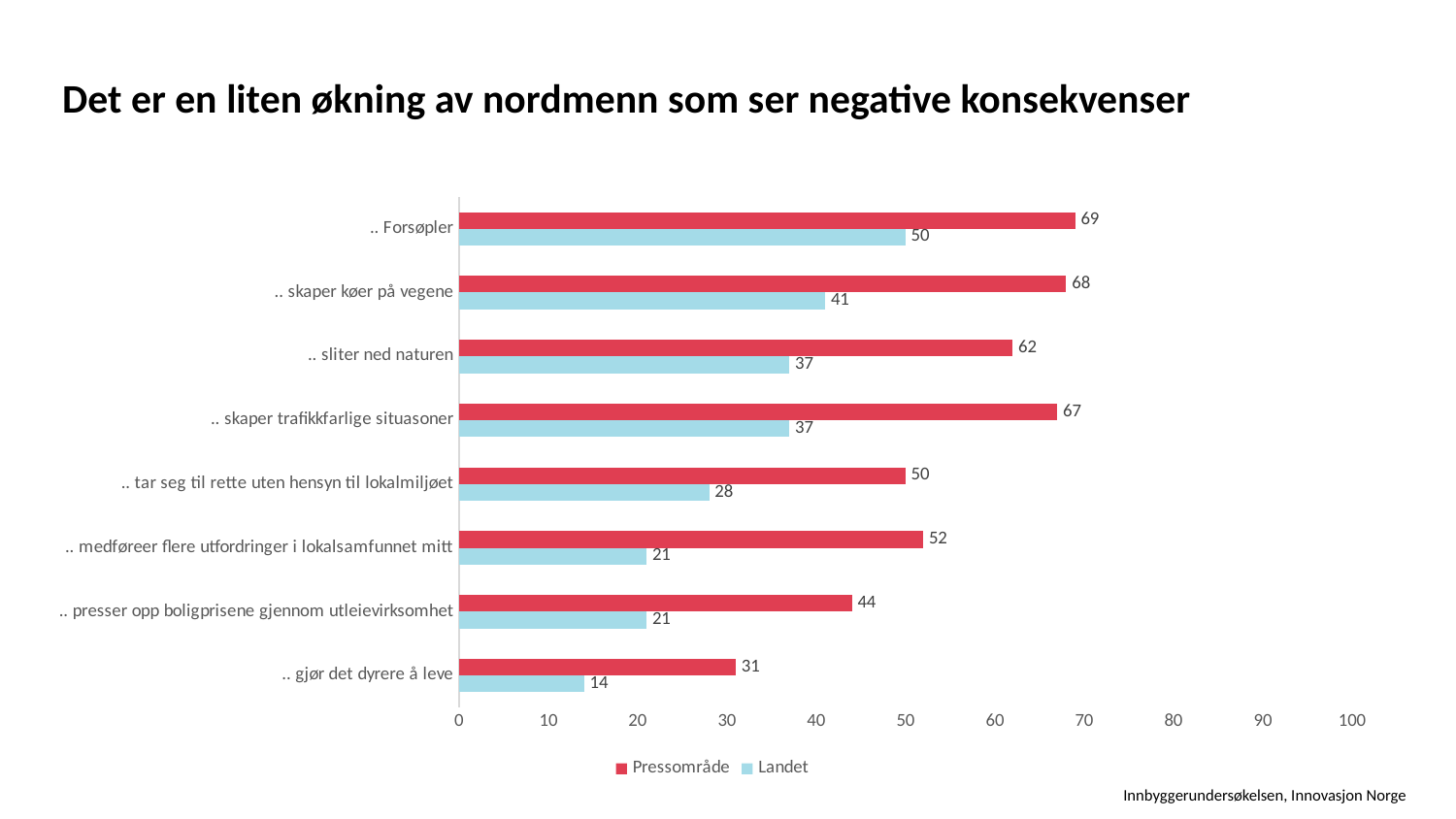
What kind of chart is shown on the slide? Bar chart What is the Landet value for ".. gjør det dyrere å leve"? 14 Which is larger: the Pressområde value for ".. presser opp boligprisene gjennom utleievirksomhet" or the Pressområde value for ".. tar seg til rette uten hensyn til lokalmiljøet"? .. tar seg til rette uten hensyn til lokalmiljøet What is the Pressområde value for ".. Forsøpler"? 69 Which category has the highest Pressområde value? .. Forsøpler How many series does the legend list? 2 What is the difference between the Pressområde values for ".. Forsøpler" and ".. gjør det dyrere å leve"? 38 What is the difference between the Pressområde and Landet values for ".. sliter ned naturen"? 25 Which colour represents the Landet series? Light blue Which category has the lowest Landet value? .. gjør det dyrere å leve What is the Landet value for ".. skaper køer på vegene"? 41 How many categories are shown on the chart? 8